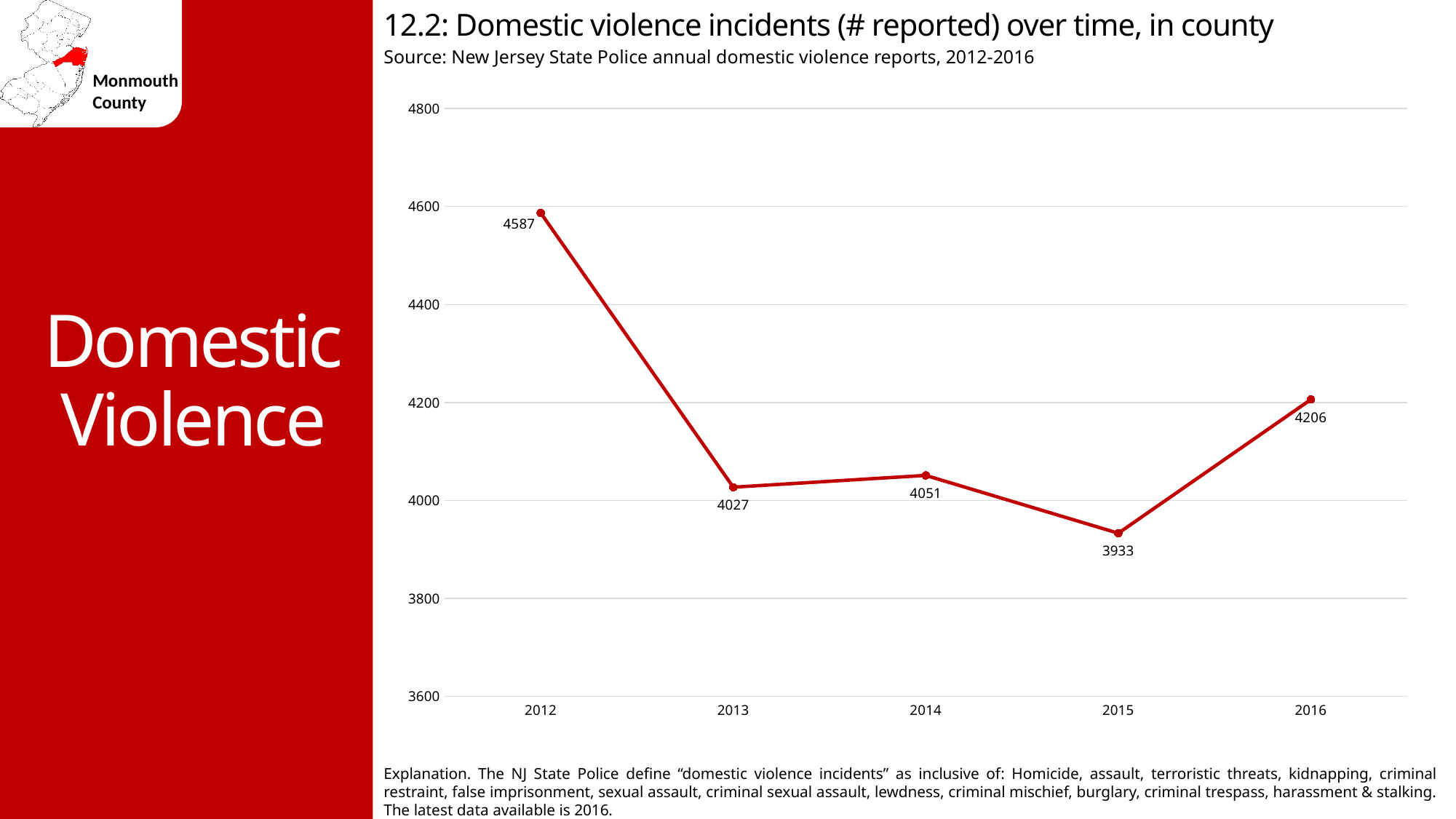
What was the number of reported domestic violence incidents in 2015? 3933 What kind of chart is shown on the slide? line chart What was the number of reported domestic violence incidents in 2012? 4587 What is the difference in reported incidents between 2012 and 2013? 560 Is the value for 2015 greater or less than 4000? less Did the number of reported incidents rise or fall from 2012 to 2013? fall What is the difference in reported incidents between 2016 and 2015? 273 What was the number of reported domestic violence incidents in 2016? 4206 Which year had the highest number of reported domestic violence incidents? 2012 Which year had more reported incidents, 2013 or 2014? 2014 How many years are plotted on the chart? 5 Which year had the lowest number of reported domestic violence incidents? 2015